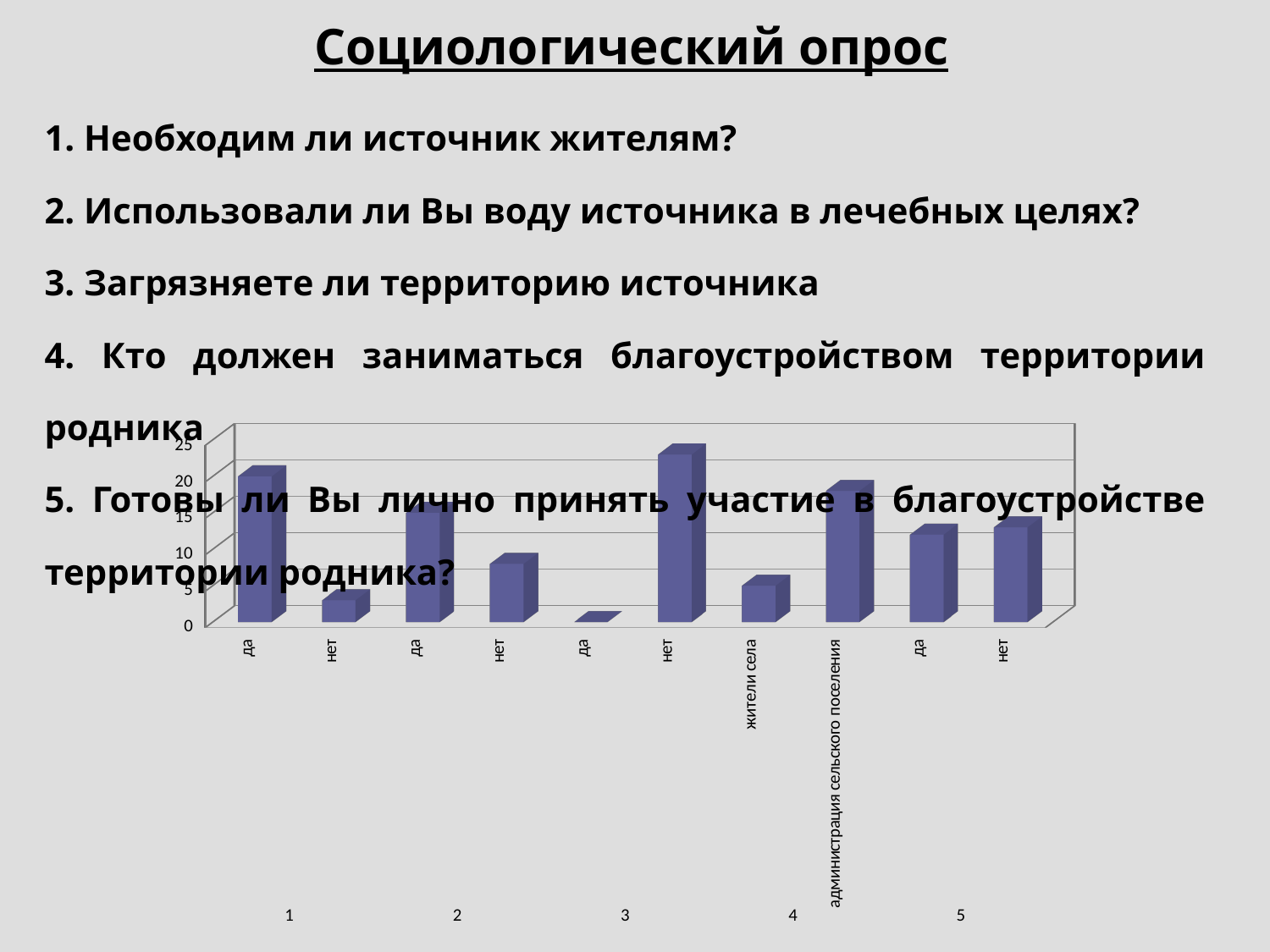
How many question groups (1–5) are labelled along the x axis of the chart? 5 Is the value for нет in question 1 greater or less than 5? less Which bar is the highest in the chart? нет for question 3 How many bars are plotted in the chart? 10 For question 1, which is larger, the bar for да or the bar for нет? да Is the value for жители села in question 4 greater or less than 10? less What kind of chart is shown on the slide? bar chart Is the value for да in question 1 greater or less than 15? greater For question 3, which is larger, the bar for да or the bar for нет? нет For question 4, which is larger, the bar for жители села or the bar for администрация сельского поселения? администрация сельского поселения Which bar is the lowest in the chart? да for question 3